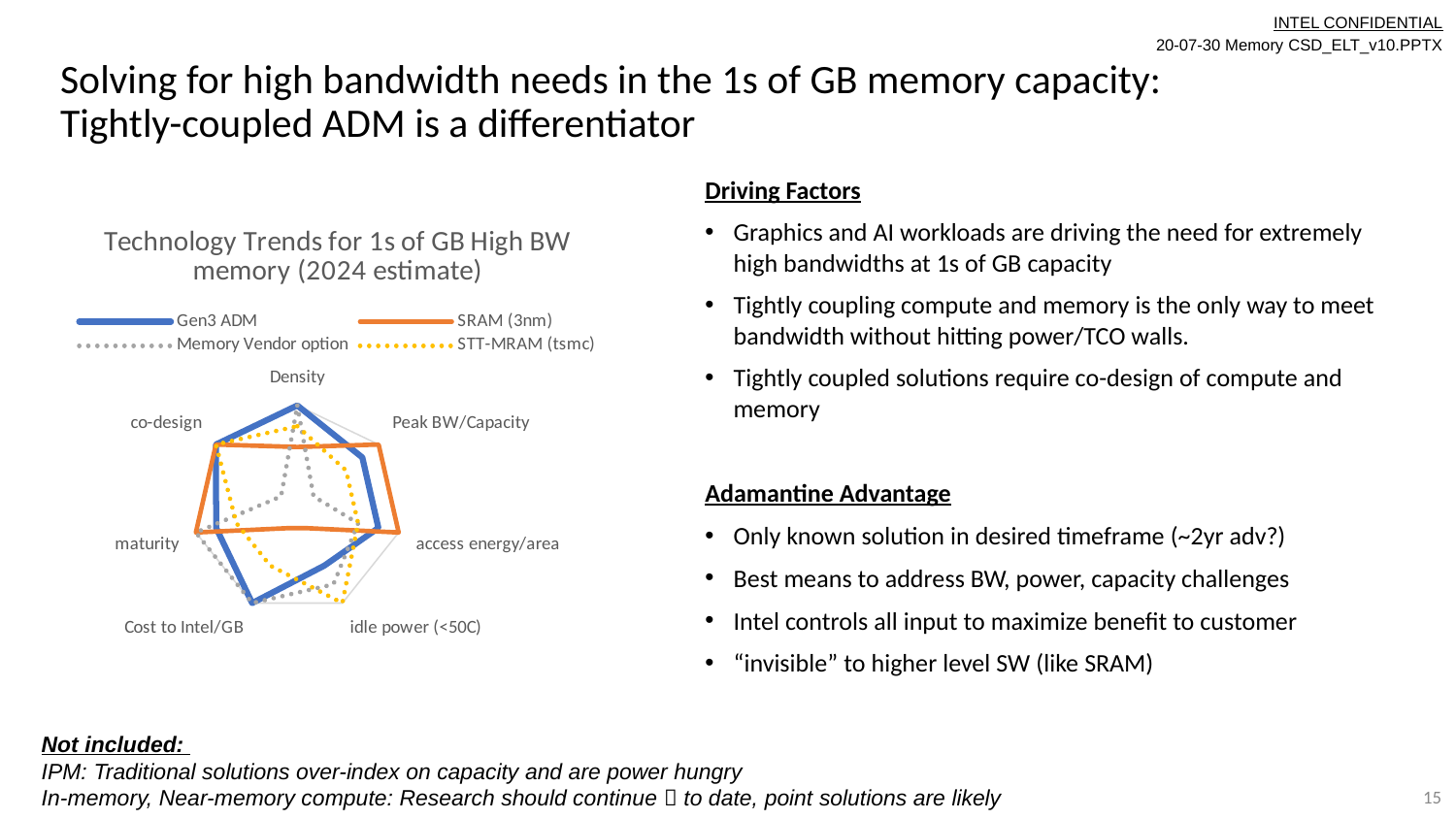
How many categories (axes) does the radar chart have? 7 On the maturity axis, which series scores higher: Gen3 ADM or SRAM (3nm)? SRAM (3nm) On the Cost to Intel/GB axis, which series scores higher: Gen3 ADM or SRAM (3nm)? Gen3 ADM How many series does the legend of the radar chart list? 4 What is the title of the radar chart? Technology Trends for 1s of GB High BW memory (2024 estimate) Which series in the radar chart is drawn with a solid blue line? Gen3 ADM On the Density axis, which series scores higher: Gen3 ADM or SRAM (3nm)? Gen3 ADM What kind of chart is shown on the slide? Radar chart